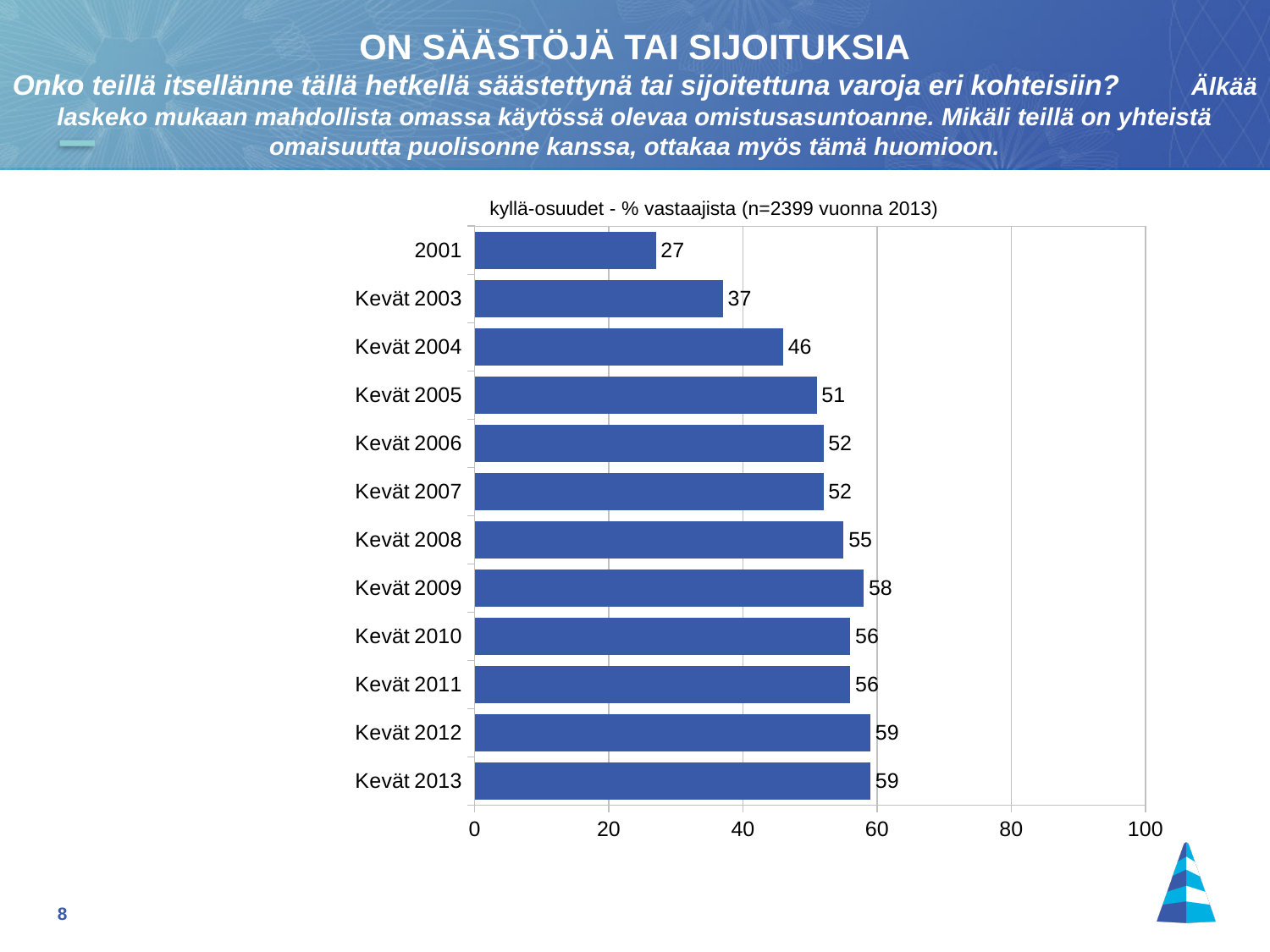
What is the value for 2001? 27 Which category has the lowest value? 2001 Do the values generally rise or fall from 2001 to Kevät 2013? rise What kind of chart is shown on the slide? bar chart How many categories are shown in the chart? 12 What is the value for Kevät 2004? 46 What is the difference between the values for Kevät 2013 and 2001? 32 What is the difference between the values for Kevät 2009 and Kevät 2010? 2 Is the value for Kevät 2012 greater or less than 40? greater Which is larger, the value for Kevät 2003 or the value for Kevät 2008? Kevät 2008 What is the title of the chart? kyllä-osuudet - % vastaajista (n=2399 vuonna 2013) What is the value for Kevät 2009? 58